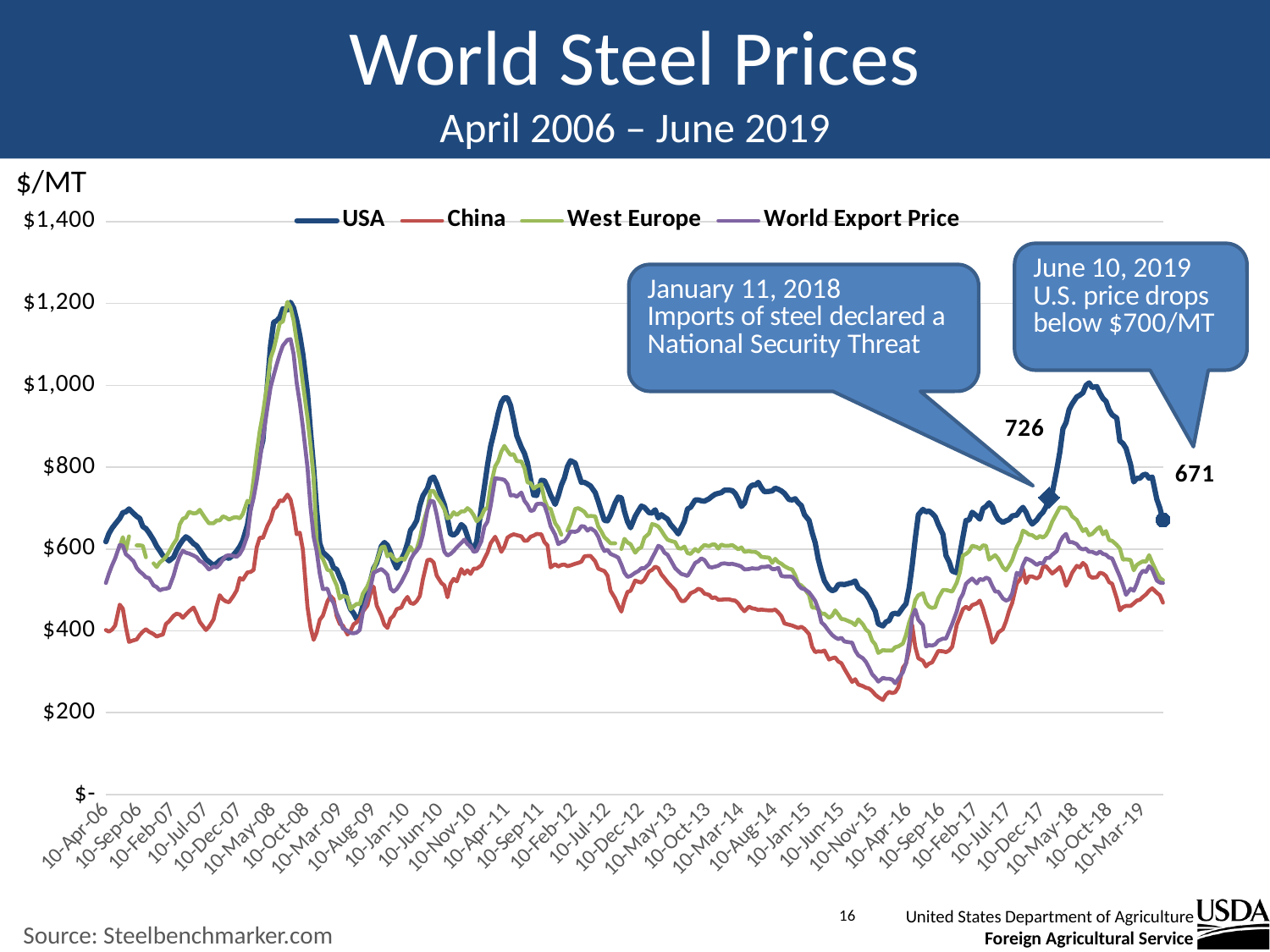
What is the difference between the USA price labelled 726 and the final labelled value of 671? 55 What unit is shown on the vertical axis of the chart? $/MT Which series reaches the highest price during 2018? USA Is the peak of the USA series in 2008 greater or less than $1,000? greater What was the USA steel price labelled at the January 11, 2018 point? 726 Does the USA series rise or fall from mid-2018 to June 2019? fall What kind of chart is shown on the slide? line chart Which is larger: the USA price on January 11, 2018 or the USA price on June 10, 2019? January 11, 2018 What is the USA steel price labelled at the final point (June 10, 2019)? 671 Which series has the lowest price in late 2015? China How many series does the legend list? 4 Is the lowest value of the China series (around late 2015) greater or less than $400? less